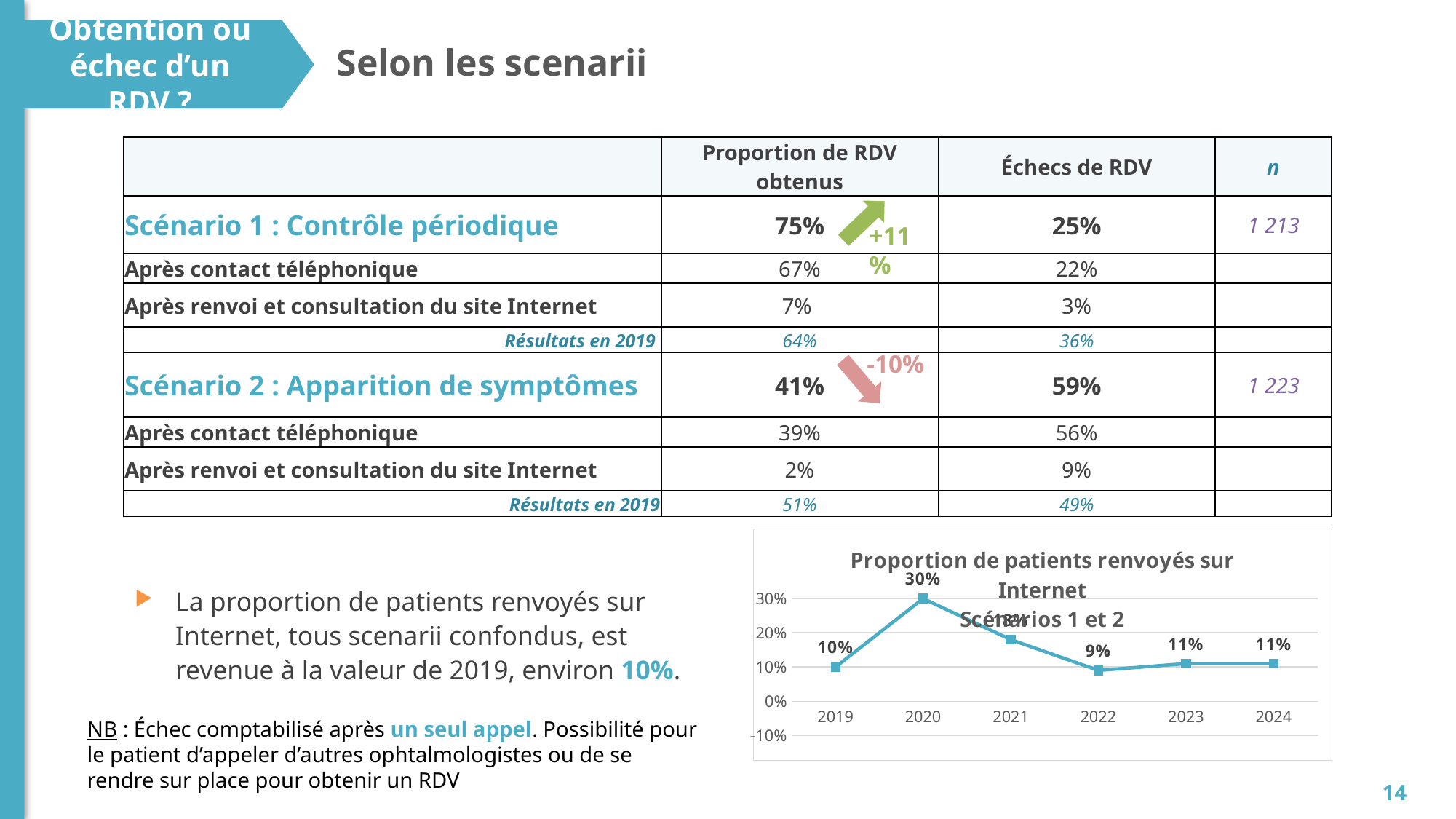
Do the values rise or fall from 2020 to 2022? fall What is the difference between the 2020 and 2019 values in the chart? 20 percentage points Which year has the highest proportion of patients referred to the Internet? 2020 How many years are plotted on the x axis of the chart? 6 What is the proportion of patients referred to the Internet in 2022? 9% What is the proportion of patients referred to the Internet in 2019? 10% What is the proportion of patients referred to the Internet in 2020? 30% What is the proportion of patients referred to the Internet in 2024? 11% Is the value for 2021 greater or less than 10%? greater What type of chart is shown on the slide? line chart Which year has the larger value, 2019 or 2022? 2019 Which year has the lowest proportion of patients referred to the Internet? 2022